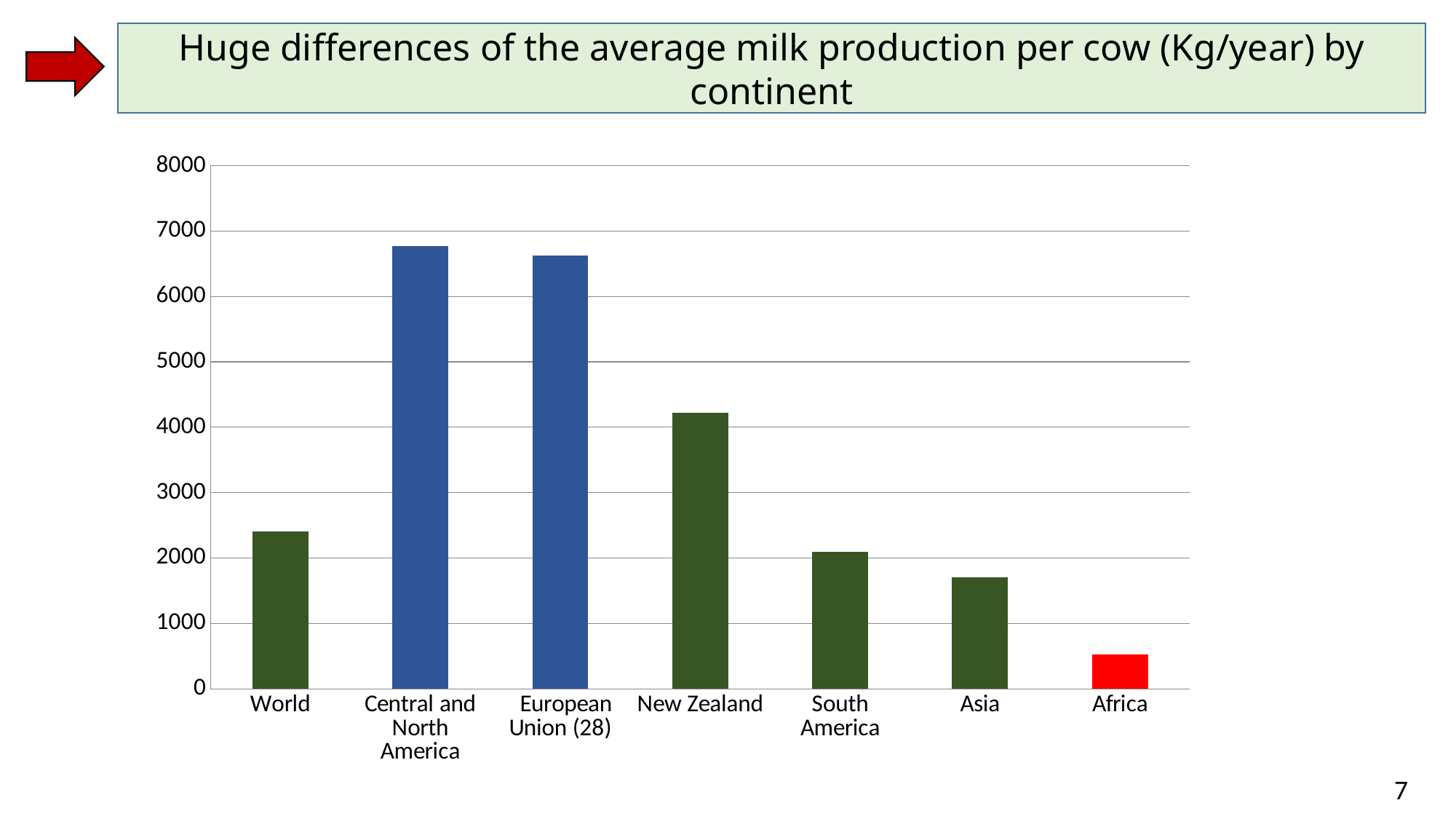
Is the value for Central and North America greater or less than 6000? greater Is the value for European Union (28) greater or less than 7000? less Which has a higher value, South America or Asia? South America Is the value for World greater or less than 2000? greater What kind of chart is shown on the slide? bar chart Which category has the lowest average milk production per cow? Africa How many categories are shown on the x axis of the chart? 7 What colour is the bar for Africa? red Which has a higher value, New Zealand or World? New Zealand